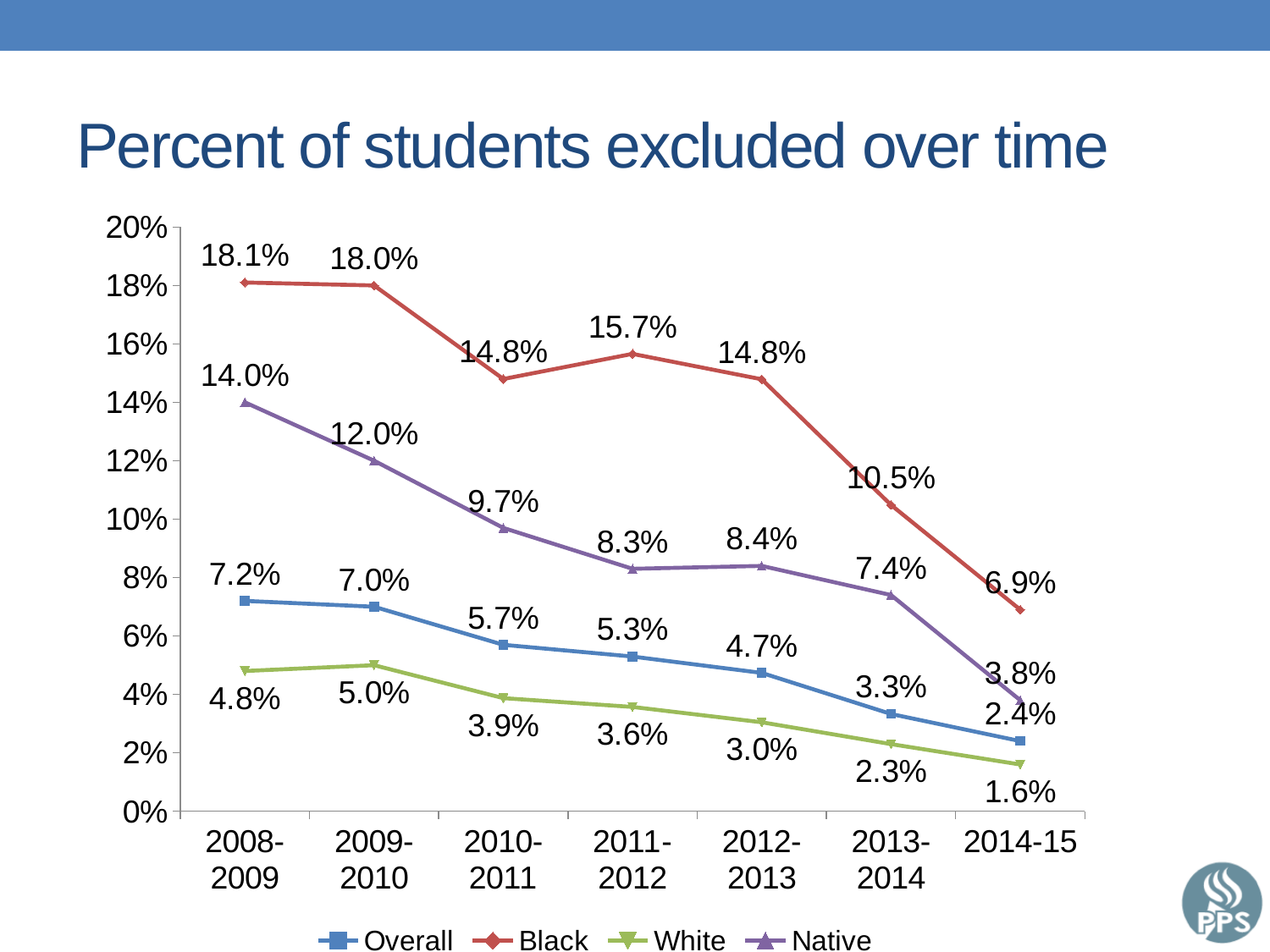
What is the value for Native students in 2010-2011? 9.7% What is the difference between the Black value and the Overall value in 2013-2014? 7.2% How many school years are plotted along the x axis? 7 What is the Overall value in 2014-15? 2.4% What type of chart is shown on the slide? Line chart Which is larger, the Native value in 2012-2013 or the Native value in 2011-2012? 2012-2013 Does the Black series generally rise or fall from 2008-2009 to 2014-15? Fall Which series has the highest value in 2011-2012? Black How many series does the legend list? 4 What is the value for White students in 2012-2013? 3.0% What is the value for Black students in 2008-2009? 18.1% Which series has the lowest value in 2014-15? White